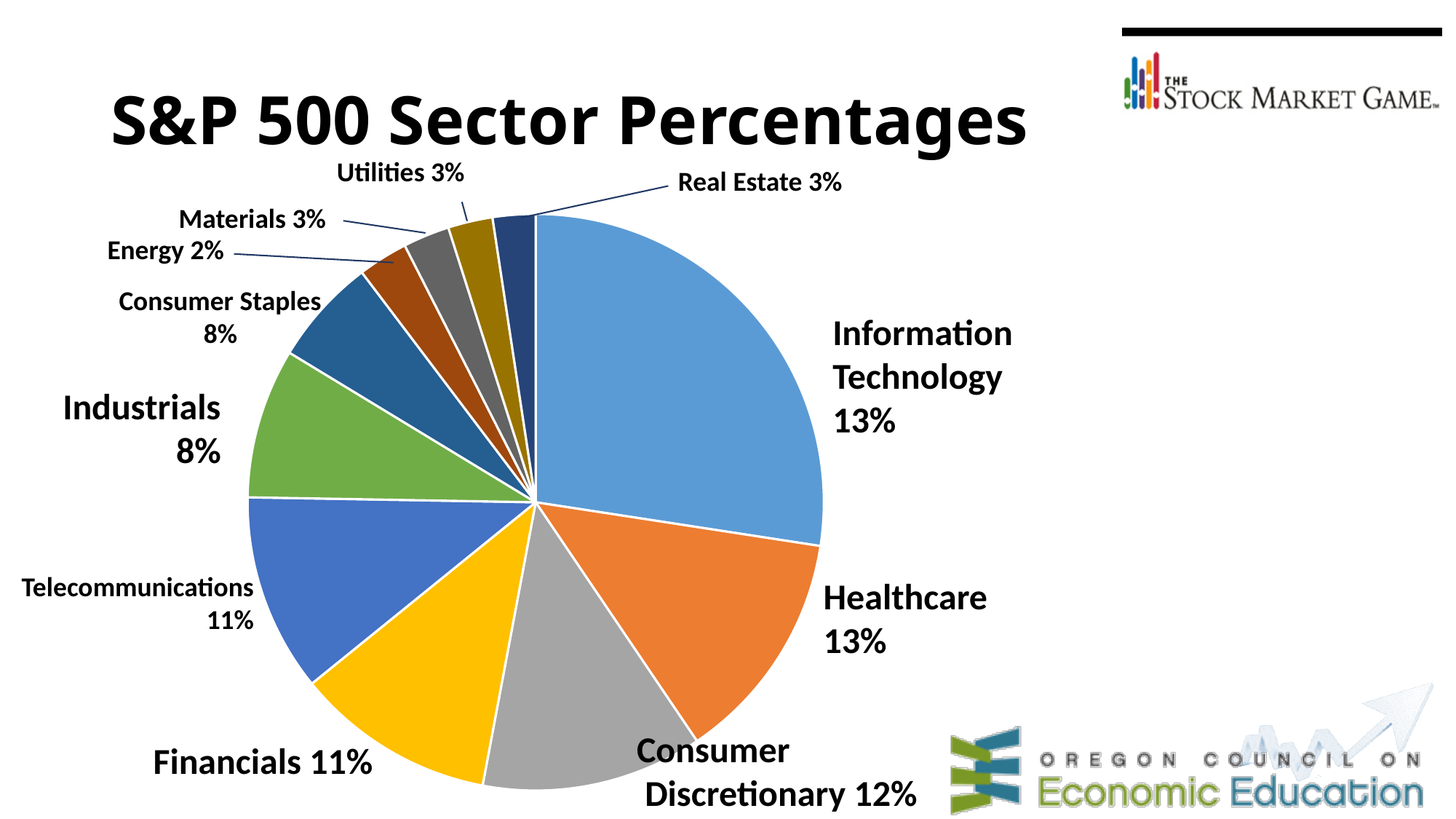
Which is larger, the Consumer Discretionary slice or the Financials slice? Consumer Discretionary What percentage does the Healthcare slice represent? 13% Which is larger, the Consumer Staples slice or the Utilities slice? Consumer Staples What percentage does the Energy slice represent? 2% What percentage does the Telecommunications slice represent? 11% What type of chart is shown on the slide? Pie chart What is the difference in percentage points between Financials and Materials? 8 What percentage does the Consumer Discretionary slice represent? 12% How many sectors are shown in the pie chart? 11 What is the title of the chart? S&P 500 Sector Percentages